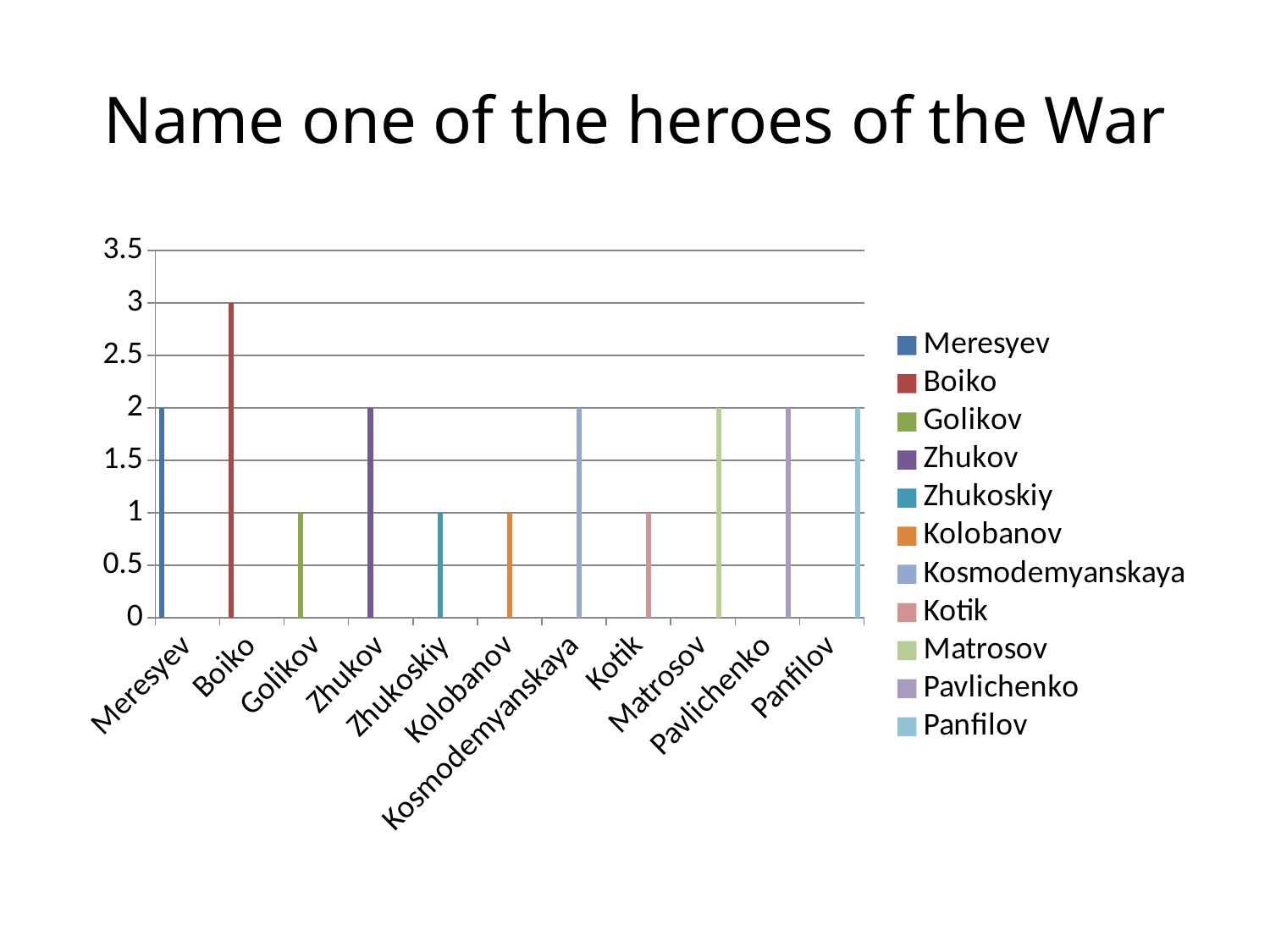
What is the value for Golikov? 1 What is the difference between the values for Boiko and Kotik? 2 What kind of chart is shown on the slide? bar chart How many entries does the legend list? 11 Which is larger, the value for Zhukov or the value for Zhukoskiy? Zhukov Which hero has the highest value in the chart? Boiko What is the value for Kosmodemyanskaya? 2 How many categories are shown on the x axis of the chart? 11 What is the value for Boiko? 3 Is the value for Boiko greater or less than 2.5? greater What is the title of the slide containing the chart? Name one of the heroes of the War What is the value for Meresyev? 2